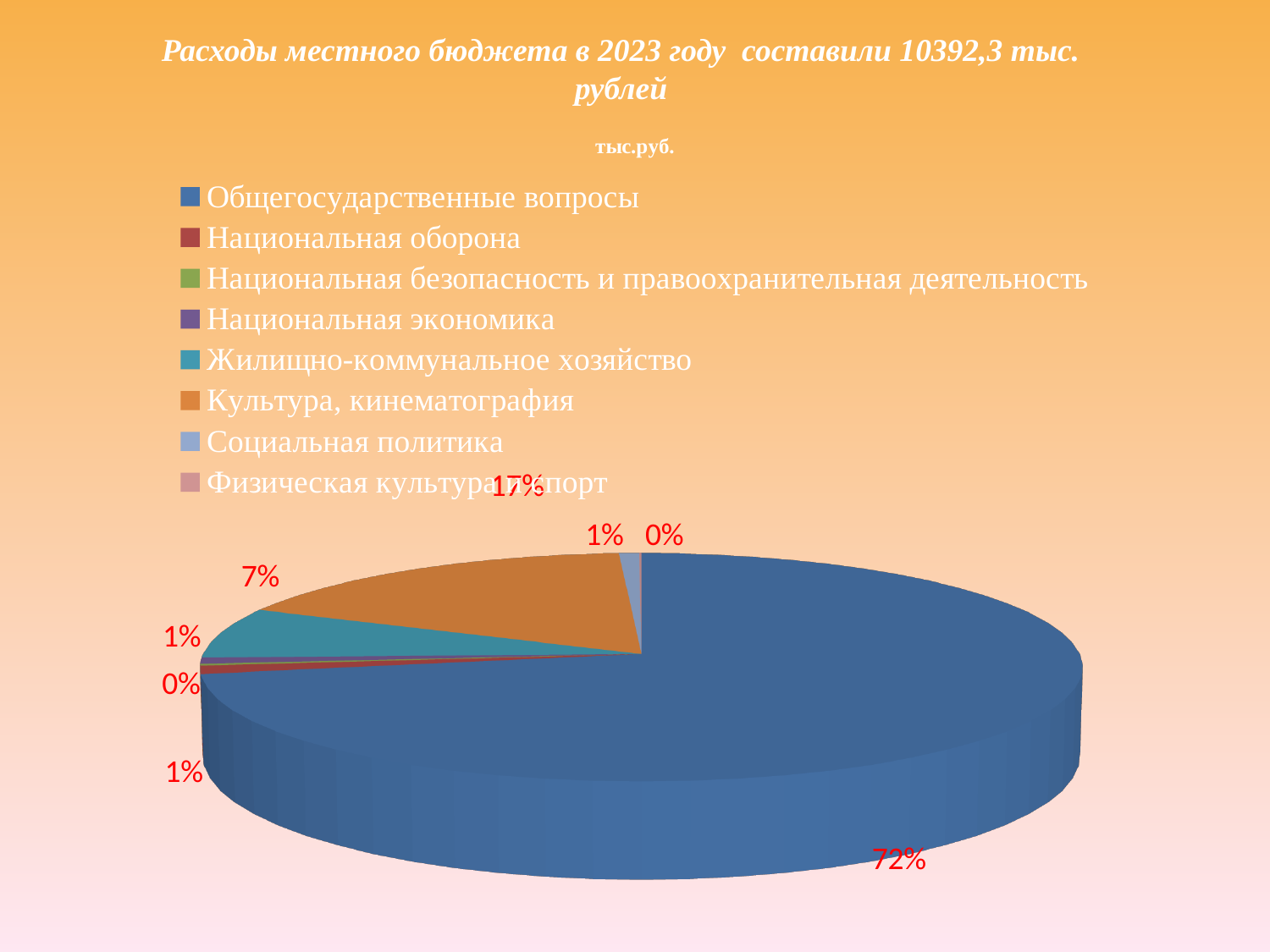
What kind of chart is shown on the slide? pie chart Which is larger, the slice for Культура, кинематография or the slice for Жилищно-коммунальное хозяйство? Культура, кинематография What share of the pie does Жилищно-коммунальное хозяйство take? 7% What unit is given in the chart title above the legend? тыс.руб. What share of the pie does Национальная оборона take? 1% Which category has the largest slice of the pie? Общегосударственные вопросы What share of the pie does Социальная политика take? 1% How many categories does the legend list? 8 What colour is the slice for Культура, кинематография? orange What is the difference in percentage points between the Общегосударственные вопросы slice and the Культура, кинематография slice? 55%